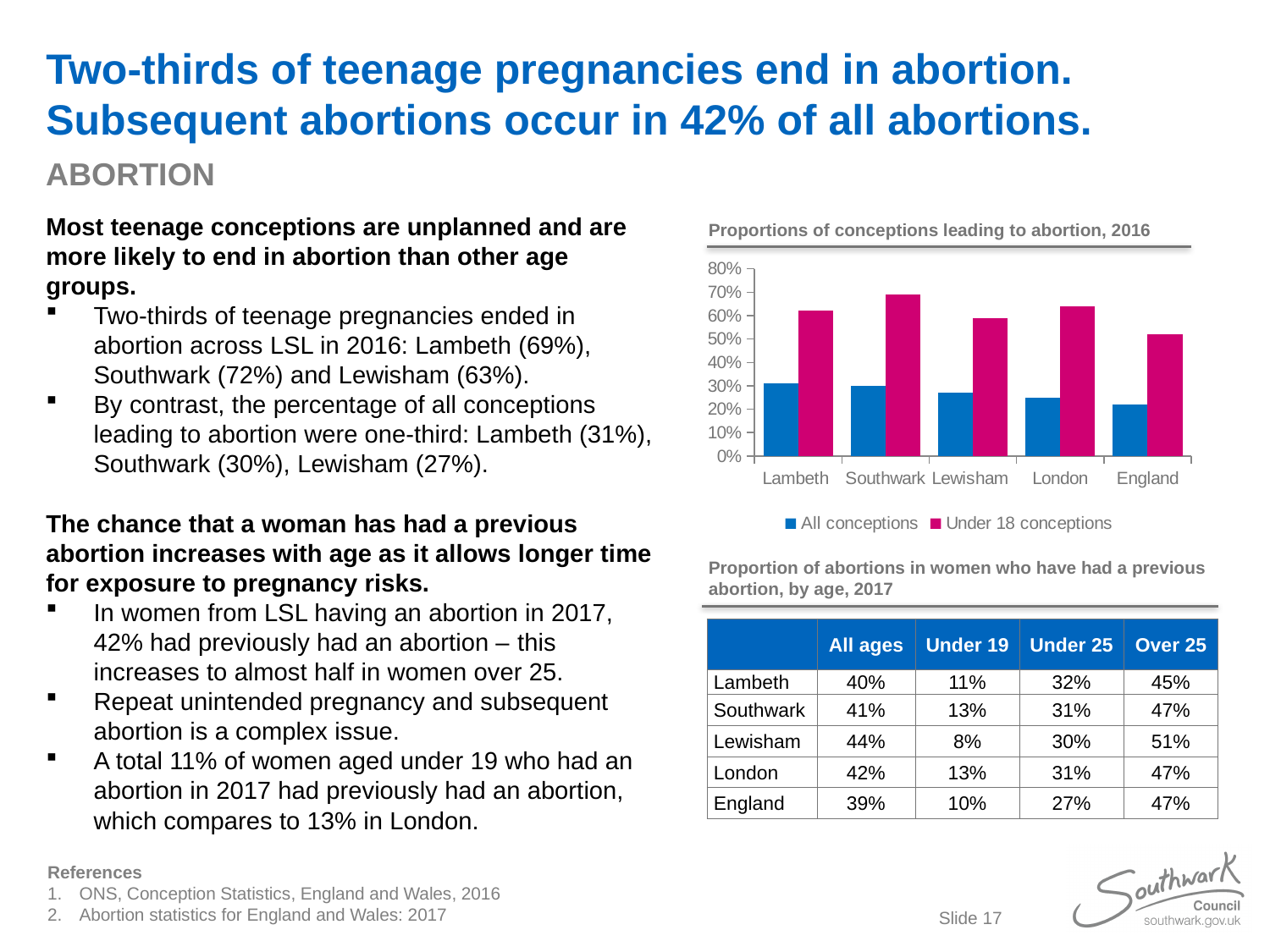
Is the value for All conceptions in England greater or less than 30%? less Which area has the lowest value for Under 18 conceptions in the chart? England Do the All conceptions values rise or fall from Lambeth to England along the x axis? fall How many series does the chart's legend list? 2 Is the value for Under 18 conceptions in England greater or less than 40%? greater Which colour represents Under 18 conceptions in the chart's legend? pink What kind of chart is shown on the slide? bar chart What is the title of the chart on the slide? Proportions of conceptions leading to abortion, 2016 Which area has the highest value for Under 18 conceptions in the chart? Southwark In the chart, which is larger for Lewisham: All conceptions or Under 18 conceptions? Under 18 conceptions Is the value for Under 18 conceptions in Southwark greater or less than 60%? greater How many areas are shown along the x axis of the chart? 5